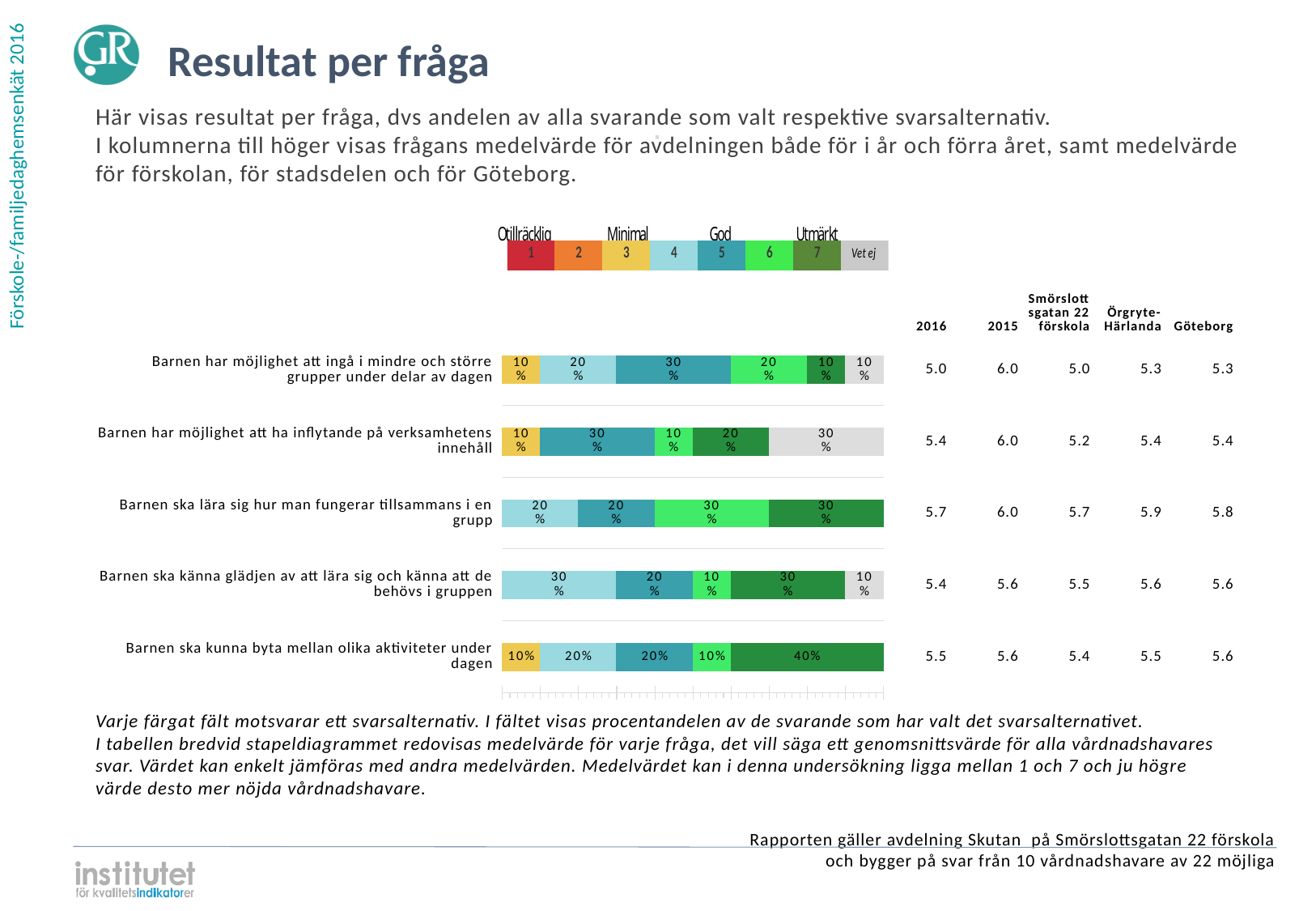
What percentage chose option 5 (teal) for 'Barnen har möjlighet att ingå i mindre och större grupper under delar av dagen'? 30% For 'Barnen ska kunna byta mellan olika aktiviteter under dagen', which is larger: the share for option 4 or the share for option 6? Option 4 (20%) Which colour represents the 'Vet ej' answer option in the legend? Grey What is the total of the segments in the bar for 'Barnen ska lära sig hur man fungerar tillsammans i en grupp'? 100% What percentage chose 'Vet ej' for 'Barnen har möjlighet att ha inflytande på verksamhetens innehåll'? 30% What percentage of respondents chose option 7 (Utmärkt, dark green) for 'Barnen ska kunna byta mellan olika aktiviteter under dagen'? 40% How many questions (categories) are plotted in the bar chart? 5 How many answer options does the legend above the chart list? 8 For 'Barnen ska lära sig hur man fungerar tillsammans i en grupp', what is the difference between the share for option 7 and the share for option 4? 10% What kind of chart is shown on the slide? Stacked bar chart Which answer option has the largest share for 'Barnen ska känna glädjen av att lära sig och känna att de behövs i gruppen'? Options 4 and 7 (30% each) What is the 2016 mean value shown for 'Barnen ska lära sig hur man fungerar tillsammans i en grupp'? 5.7